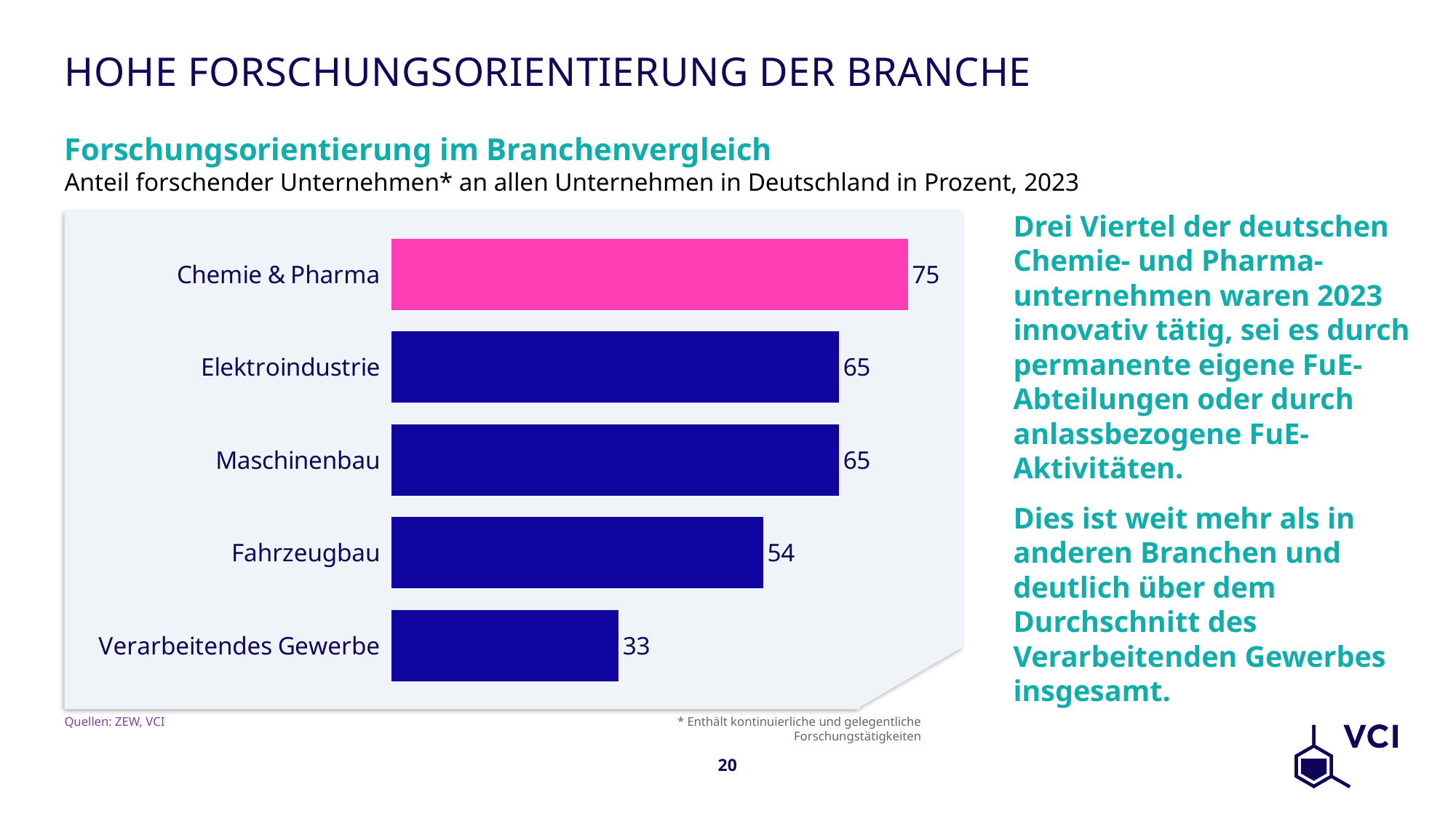
What is the value for Elektroindustrie? 65 What is the value for Chemie & Pharma? 75 How many categories are shown in the chart? 5 Which category has the lowest value? Verarbeitendes Gewerbe What is the title of the chart? Forschungsorientierung im Branchenvergleich Which category has the highest value? Chemie & Pharma What is the difference between the values for Chemie & Pharma and Verarbeitendes Gewerbe? 42 Which is larger, the value for Fahrzeugbau or the value for Maschinenbau? Maschinenbau What is the value for Verarbeitendes Gewerbe? 33 What kind of chart is shown on the slide? Bar chart What is the difference between the values for Chemie & Pharma and Maschinenbau? 10 What is the value for Fahrzeugbau? 54